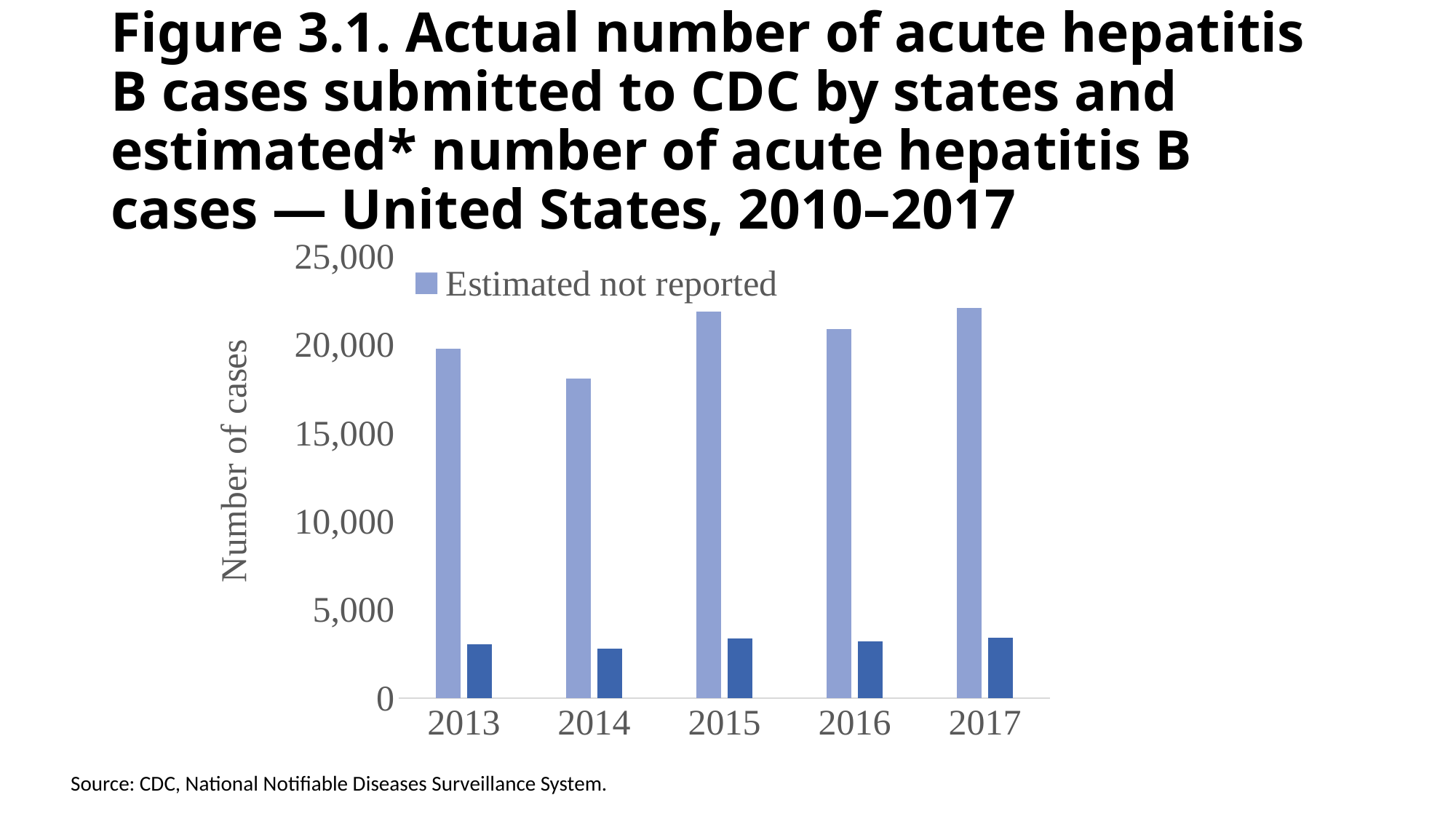
Is the Estimated not reported value for 2017 greater or less than 20,000? greater What is the label on the chart's vertical axis? Number of cases Is the dark blue bar for 2015 greater or less than 5,000? less How many years are shown on the x axis of the chart? 5 Which year has the larger Estimated not reported value, 2014 or 2015? 2015 Is the Estimated not reported value for 2014 greater or less than 20,000? less How many series does the chart's legend list? 1 What kind of chart is shown on the slide? bar chart Which year has the lowest value for the Estimated not reported series? 2014 Does the Estimated not reported value rise or fall from 2014 to 2015? rise